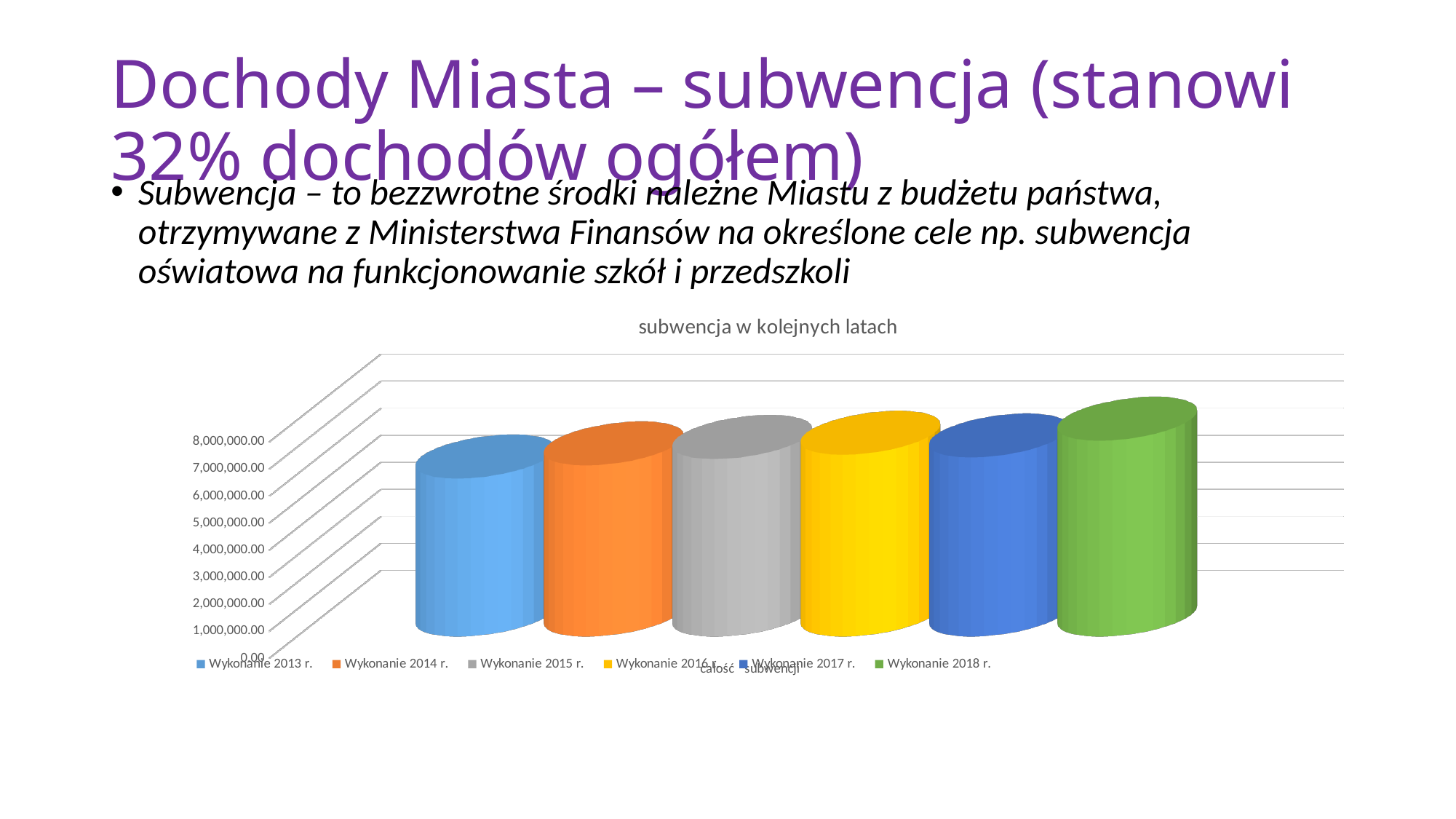
How many series does the chart legend list? 6 What is the highest value shown on the vertical axis of the chart? 8,000,000.00 Which series has the lowest value in the chart? Wykonanie 2013 r. What is the title of the chart? subwencja w kolejnych latach Do the values rise or fall from Wykonanie 2013 r. to Wykonanie 2018 r.? rise Which series has the highest value in the chart? Wykonanie 2018 r. What kind of chart is shown on the slide? bar chart Which is larger, the value for Wykonanie 2018 r. or Wykonanie 2013 r.? Wykonanie 2018 r. Which is larger, the value for Wykonanie 2014 r. or Wykonanie 2013 r.? Wykonanie 2014 r. Is the value for Wykonanie 2018 r. greater or less than 5,000,000.00? greater What colour represents Wykonanie 2018 r. in the chart? green Is the value for Wykonanie 2013 r. greater or less than 4,000,000.00? greater